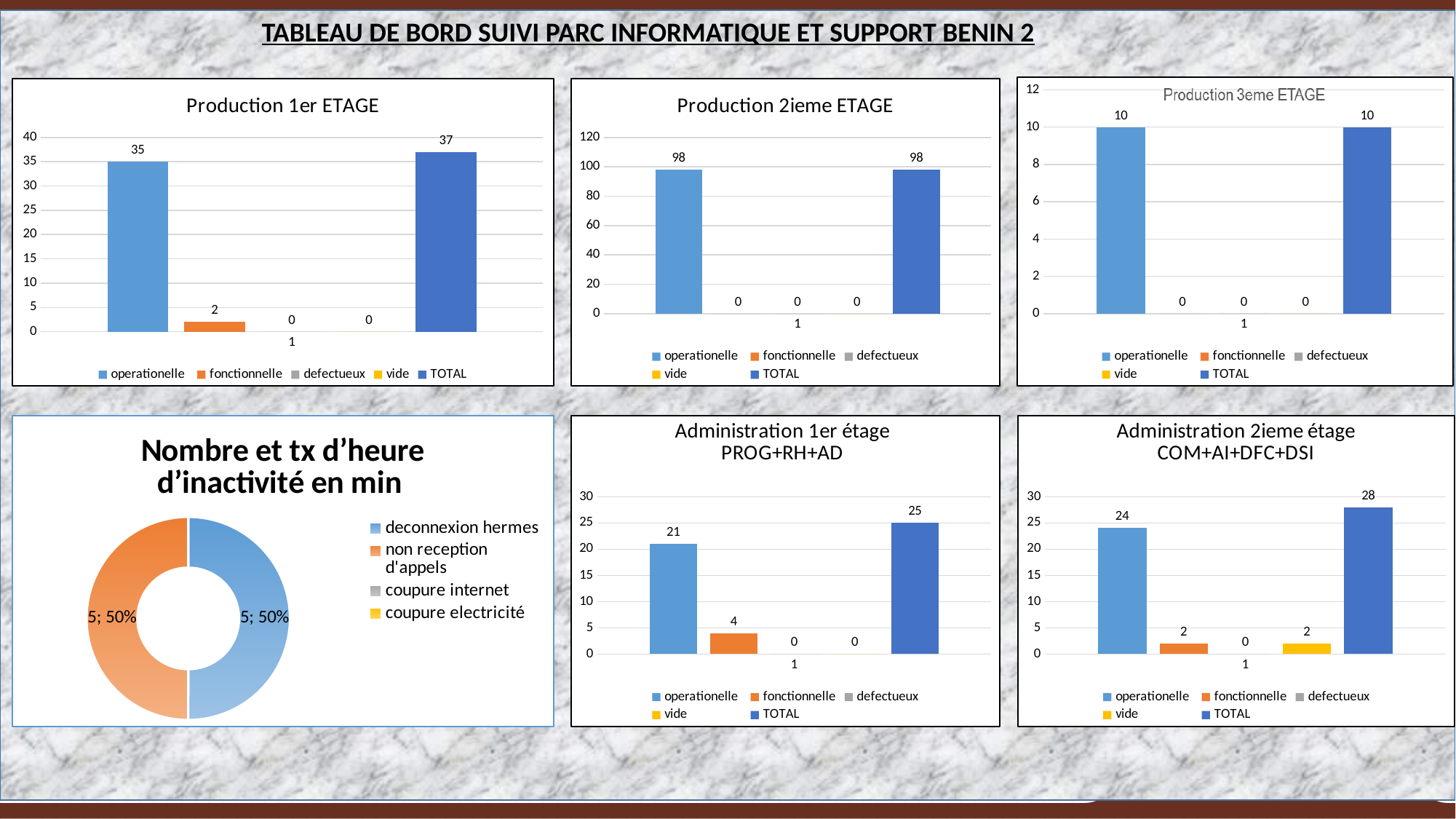
In the 'Administration 2ieme étage COM+AI+DFC+DSI' chart, what is the value for vide? 2 What kind of chart is 'Nombre et tx d'heure d'inactivité en min'? Doughnut chart In the 'Production 1er ETAGE' chart, what is the value for operationelle? 35 In the 'Production 1er ETAGE' chart, what is the value for TOTAL? 37 In the 'Administration 2ieme étage COM+AI+DFC+DSI' chart, what is the difference between TOTAL and operationelle? 4 In the 'Production 3eme ETAGE' chart, what is the value for TOTAL? 10 In the 'Production 1er ETAGE' chart, which is larger, operationelle or fonctionnelle? operationelle In the 'Production 2ieme ETAGE' chart, what is the value for operationelle? 98 In the 'Administration 1er étage PROG+RH+AD' chart, which series has the highest value? TOTAL In the 'Nombre et tx d'heure d'inactivité en min' chart, what share does deconnexion hermes have? 50% In the 'Administration 1er étage PROG+RH+AD' chart, what is the value for fonctionnelle? 4 How many series does the legend of the 'Production 2ieme ETAGE' chart list? 5